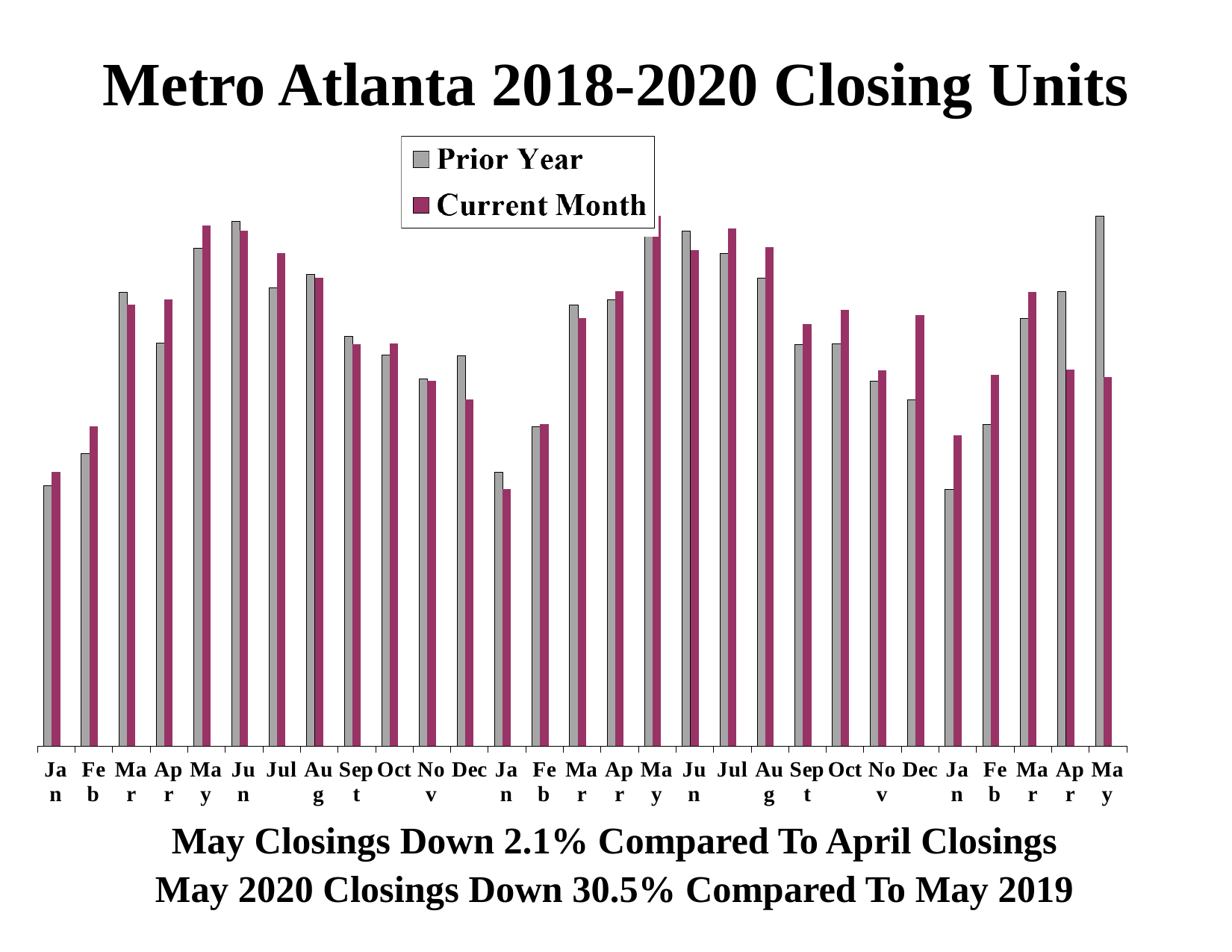
What are the two series named in the legend? Prior Year and Current Month What kind of chart is shown on the slide? bar chart What is the title of the chart? Metro Atlanta 2018-2020 Closing Units Do the Current Month values rise or fall from the first January to the first June on the x axis? rise Which month has the lowest Current Month bar? the second January (January 2019) Do the Current Month values rise or fall from the first June to the second January on the x axis? fall For the second December on the x axis (December 2019), which is larger: the Prior Year bar or the Current Month bar? Current Month How many months (categories) are plotted along the x axis? 29 For the final May on the x axis (May 2020), which is larger: the Prior Year bar or the Current Month bar? Prior Year How many series does the legend list? 2 For the second January on the x axis (January 2019), which is larger: the Prior Year bar or the Current Month bar? Prior Year Which month has the highest Current Month bar? the second May (May 2019)